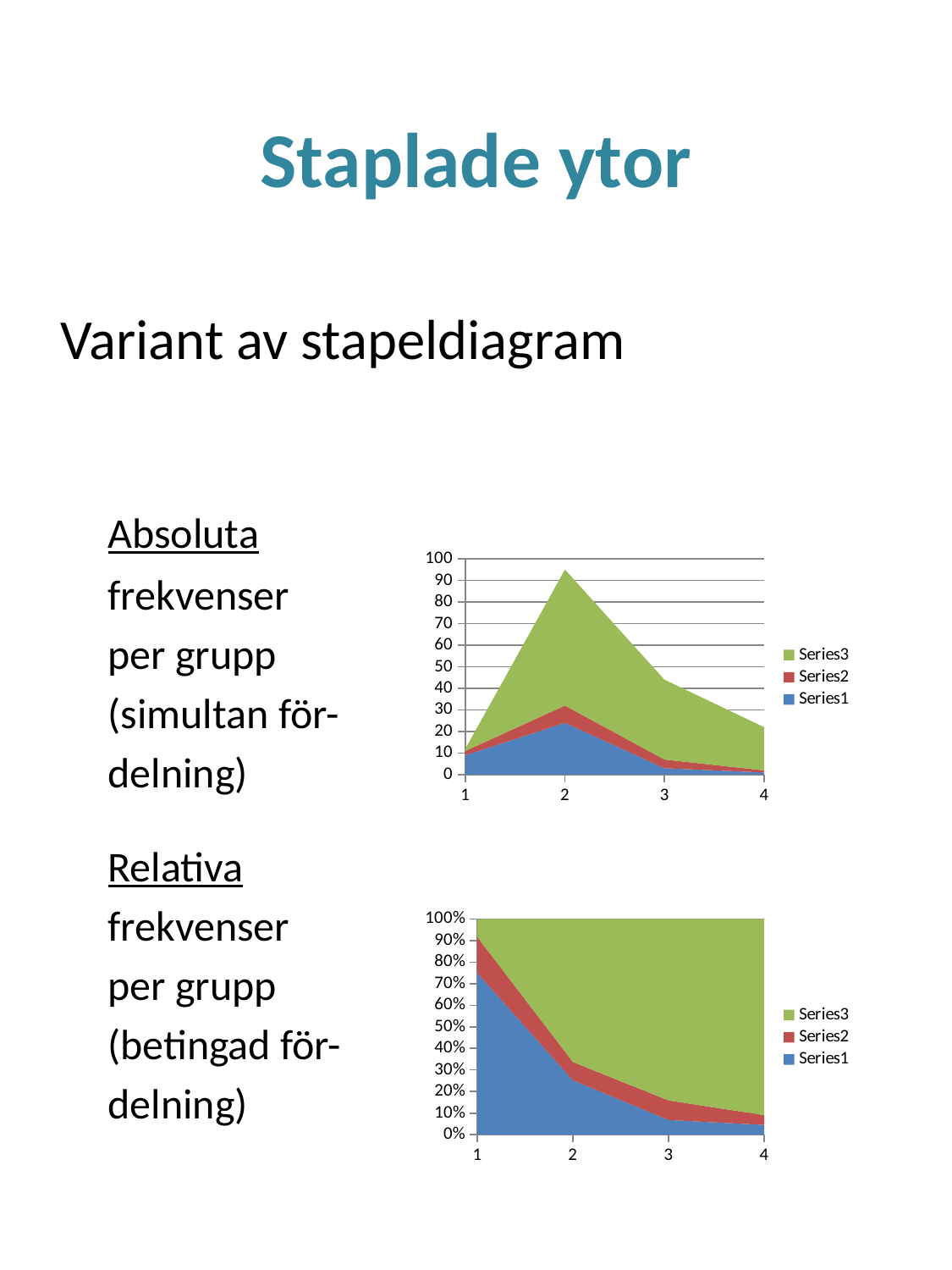
In the bottom chart, is the share of Series1 at category 1 greater or less than 60%? greater In the top chart, is the stacked total at category 2 greater or less than 80? greater How many series does the legend of the top chart list? 3 In the top chart, at which x-axis category is the stacked total highest? 2 How many categories are shown on the x axis of the bottom chart? 4 In the bottom chart, is the share of Series1 at category 4 greater or less than 10%? less In the bottom chart, does the share of Series1 rise or fall along the x axis from category 1 to category 4? fall In the top chart, does the stacked total rise or fall from category 2 to category 4? fall In the top chart, at which x-axis category is the stacked total lowest? 1 What colour represents Series3 in the legend of the bottom chart? green What kind of chart is the top chart on the slide? stacked area chart